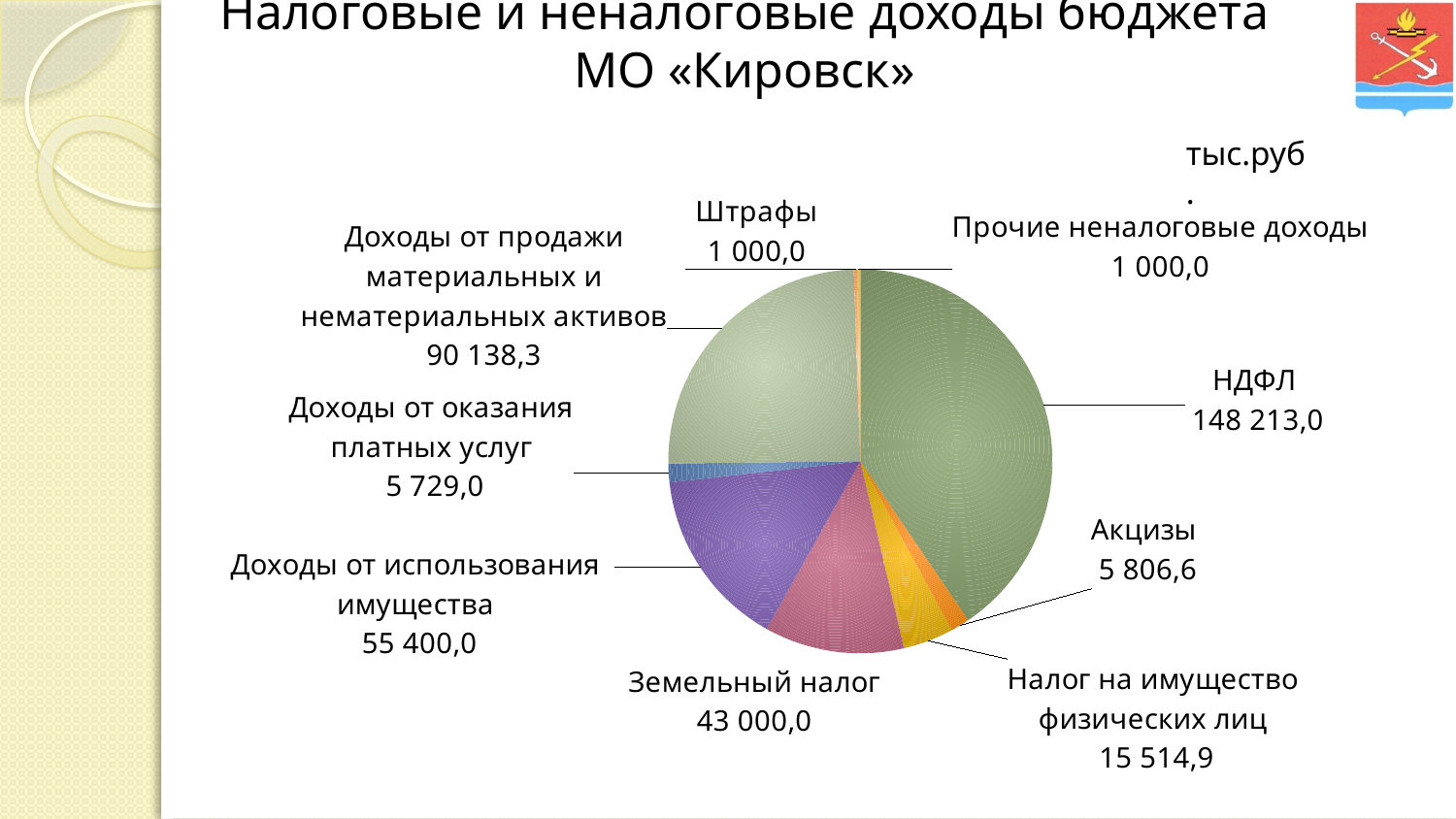
Which is larger, Доходы от использования имущества or Налог на имущество физических лиц? Доходы от использования имущества What kind of chart is shown on the slide? pie chart How many slices does the pie chart have? 9 What is the value for Доходы от продажи материальных и нематериальных активов? 90 138,3 What is the value for Акцизы? 5 806,6 What is the value for НДФЛ? 148 213,0 What is the value for Налог на имущество физических лиц? 15 514,9 What is the difference between Доходы от использования имущества and Земельный налог? 12 400,0 Which category has the largest slice of the pie? НДФЛ What is the value for Земельный налог? 43 000,0 What is the difference between НДФЛ and Земельный налог? 105 213,0 In what units are the values on the chart given? тыс.руб.